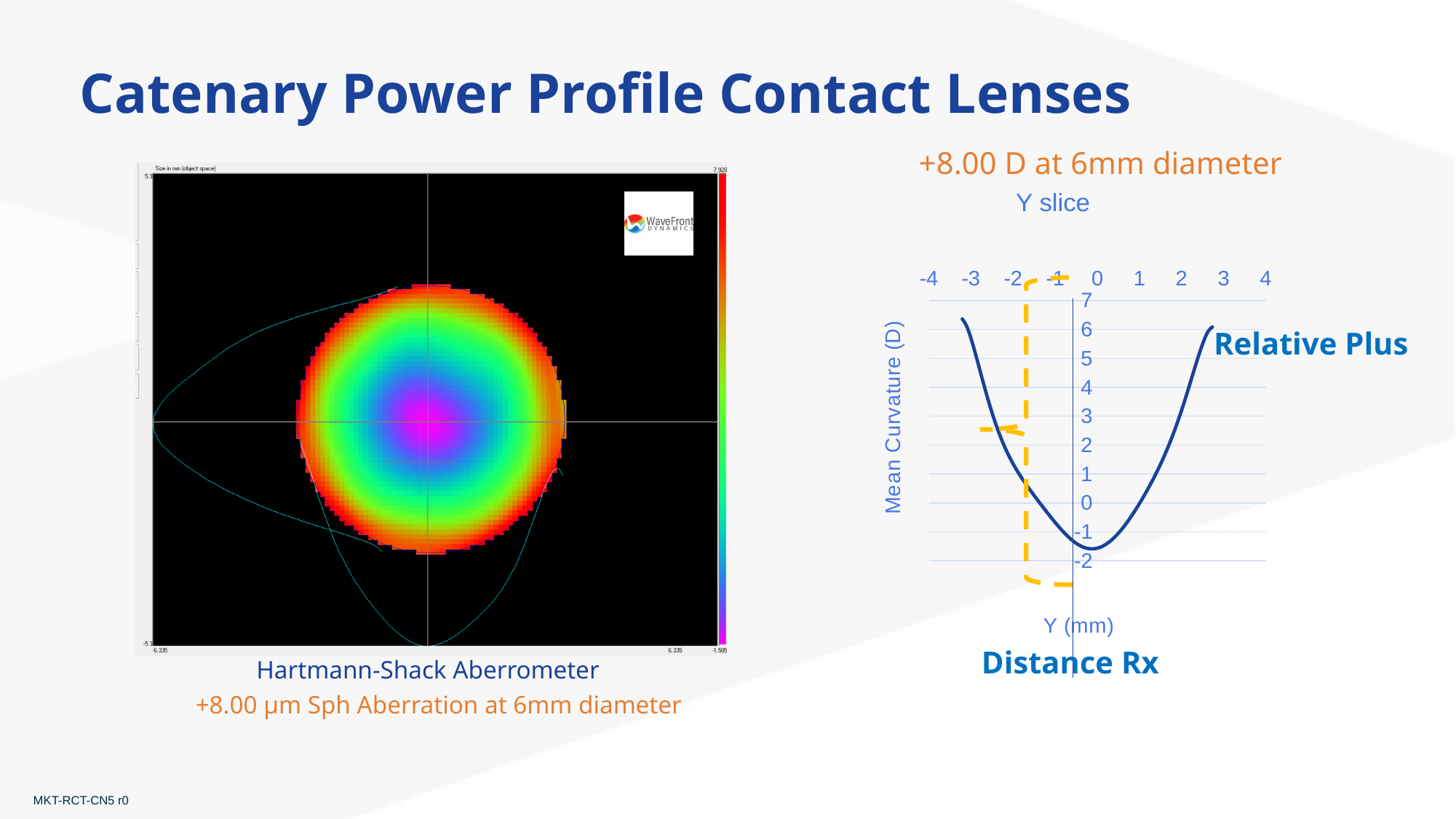
In the "Y slice" chart, is the mean curvature at Y = -2 mm greater or less than 4? less In the "Y slice" chart, which has the larger mean curvature: Y = -3 mm or Y = 0 mm? Y = -3 mm In the "Y slice" chart, does the mean curvature rise or fall as Y goes from 0 mm to 3 mm? rise In the "Y slice" chart, is the mean curvature at Y = -3 mm greater or less than 5? greater In the "Y slice" chart, does the mean curvature rise or fall as Y goes from -3 mm to 0 mm? fall In the "Y slice" chart, what is the label of the vertical axis? Mean Curvature (D) In the "Y slice" chart, what is the highest value shown on the vertical axis? 7 How many tick labels are shown on the horizontal axis of the "Y slice" chart? 9 What kind of chart is the chart on the right of the slide titled "Y slice"? line chart In the "Y slice" chart, is the mean curvature at Y = 0 mm greater or less than 0? less In the "Y slice" chart, what is the label of the horizontal axis? Y (mm)